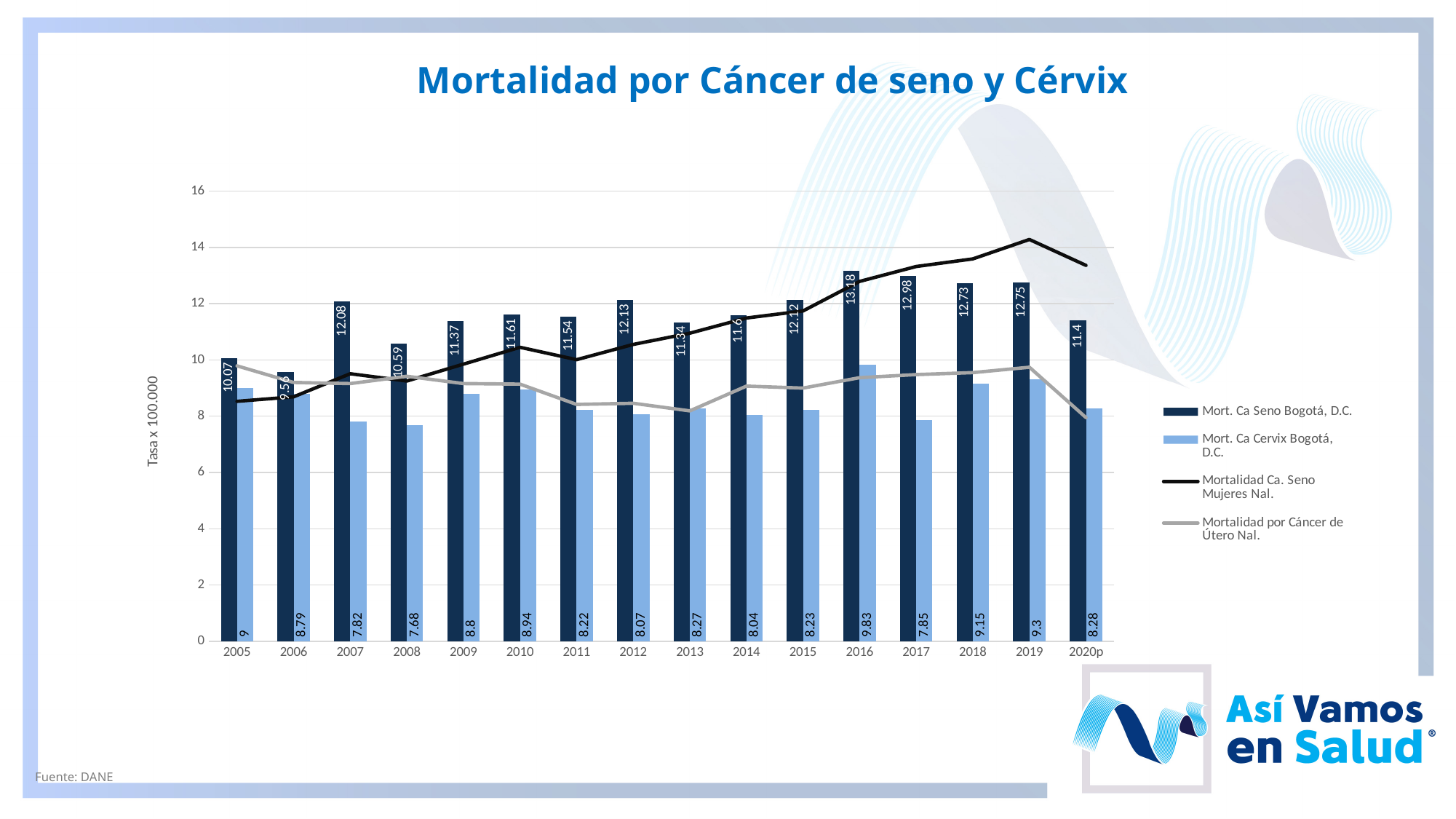
What is the title of the chart? Mortalidad por Cáncer de seno y Cérvix What is the difference between Mort. Ca Seno Bogotá, D.C. and Mort. Ca Cervix Bogotá, D.C. in 2016? 3.35 In which year is Mort. Ca Seno Bogotá, D.C. highest? 2016 What is the value of Mort. Ca Seno Bogotá, D.C. for 2020p? 11.4 What is the value of Mort. Ca Seno Bogotá, D.C. for 2016? 13.18 How many series does the legend list? 4 In which year is Mort. Ca Seno Bogotá, D.C. lowest? 2006 Is the value of Mortalidad Ca. Seno Mujeres Nal. in 2005 greater or less than 10? less In which year is Mort. Ca Cervix Bogotá, D.C. highest? 2016 What is the value of Mort. Ca Cervix Bogotá, D.C. for 2008? 7.68 How many years are shown on the x axis? 16 Which is larger, Mort. Ca Cervix Bogotá, D.C. in 2019 or in 2017? 2019